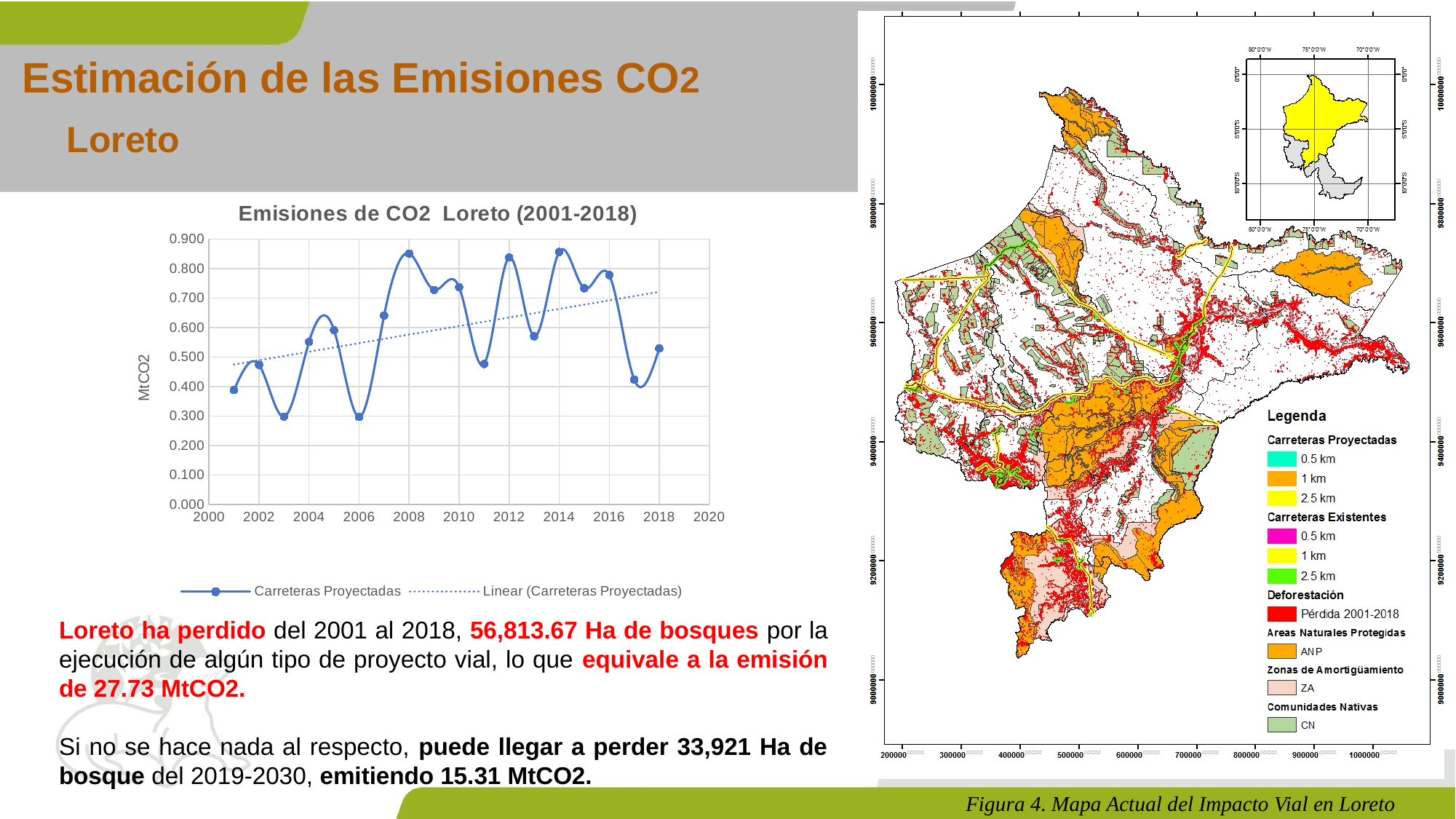
In the chart 'Emisiones de CO2 Loreto (2001-2018)', which year has the larger value, 2008 or 2003? 2008 In the chart 'Emisiones de CO2 Loreto (2001-2018)', is the value for 2017 greater or less than 0.500? less In the chart 'Emisiones de CO2 Loreto (2001-2018)', which year has the larger value, 2016 or 2017? 2016 How many data points are plotted in the chart 'Emisiones de CO2 Loreto (2001-2018)'? 18 In the chart 'Emisiones de CO2 Loreto (2001-2018)', is the value for 2008 greater or less than 0.800? greater What type of chart is 'Emisiones de CO2 Loreto (2001-2018)'? Line chart What is the y-axis label of the chart 'Emisiones de CO2 Loreto (2001-2018)'? MtCO2 In the chart 'Emisiones de CO2 Loreto (2001-2018)', is the value for 2003 greater or less than 0.400? less In the chart 'Emisiones de CO2 Loreto (2001-2018)', which year has the larger value, 2012 or 2013? 2012 How many entries does the legend of the chart 'Emisiones de CO2 Loreto (2001-2018)' list? 2